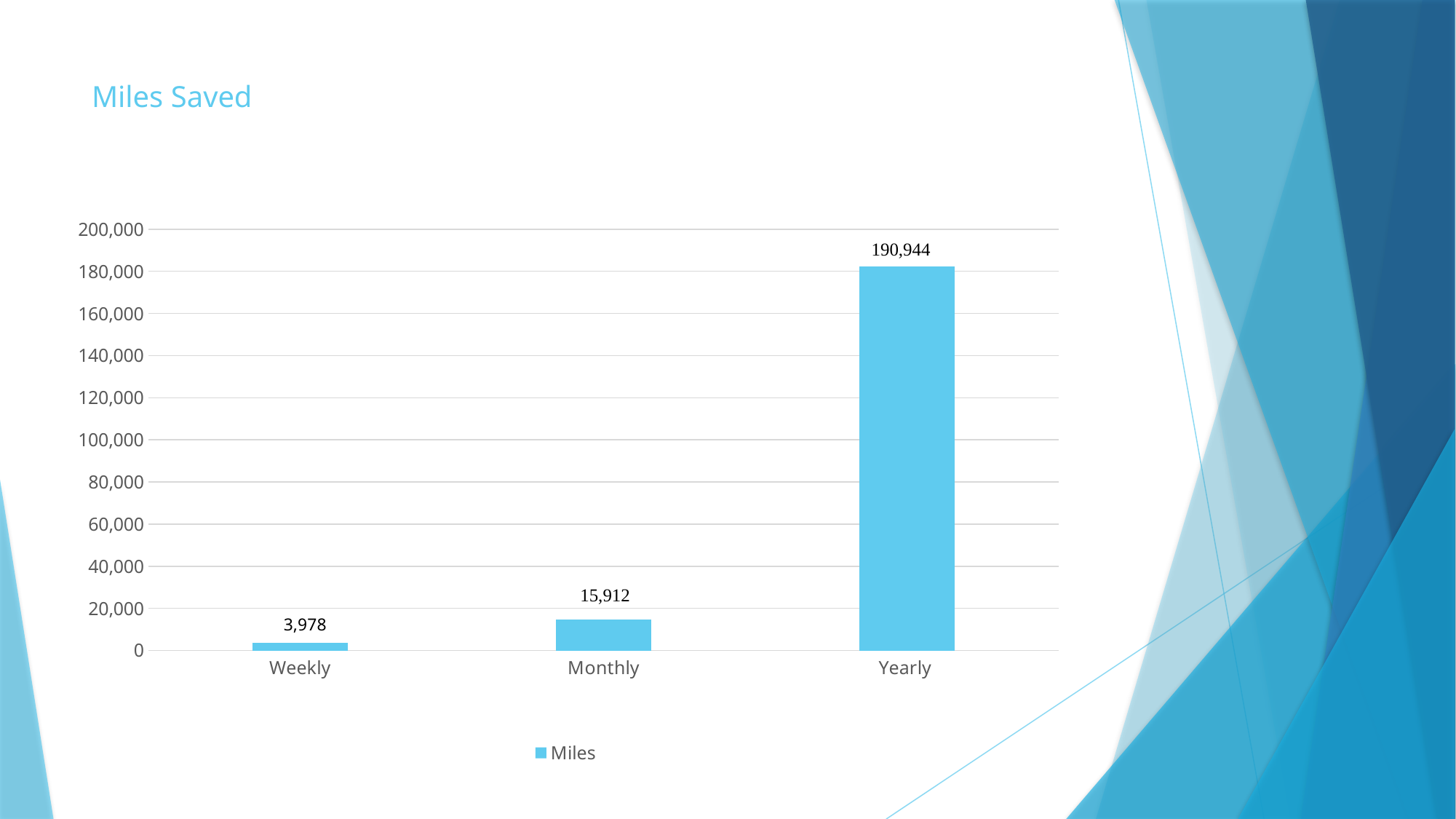
What kind of chart is shown on the slide? bar chart What is the difference between the Yearly and Monthly values? 175,032 Which category has the highest value? Yearly What is the value for Yearly? 190,944 Which is larger, the value for Monthly or the value for Weekly? Monthly Which category has the lowest value? Weekly How many categories are shown on the x axis? 3 What is the value for Weekly? 3,978 What is the value for Monthly? 15,912 Is the value for Yearly greater or less than 180,000? greater How many series does the legend list? 1 What is the difference between the Monthly and Weekly values? 11,934